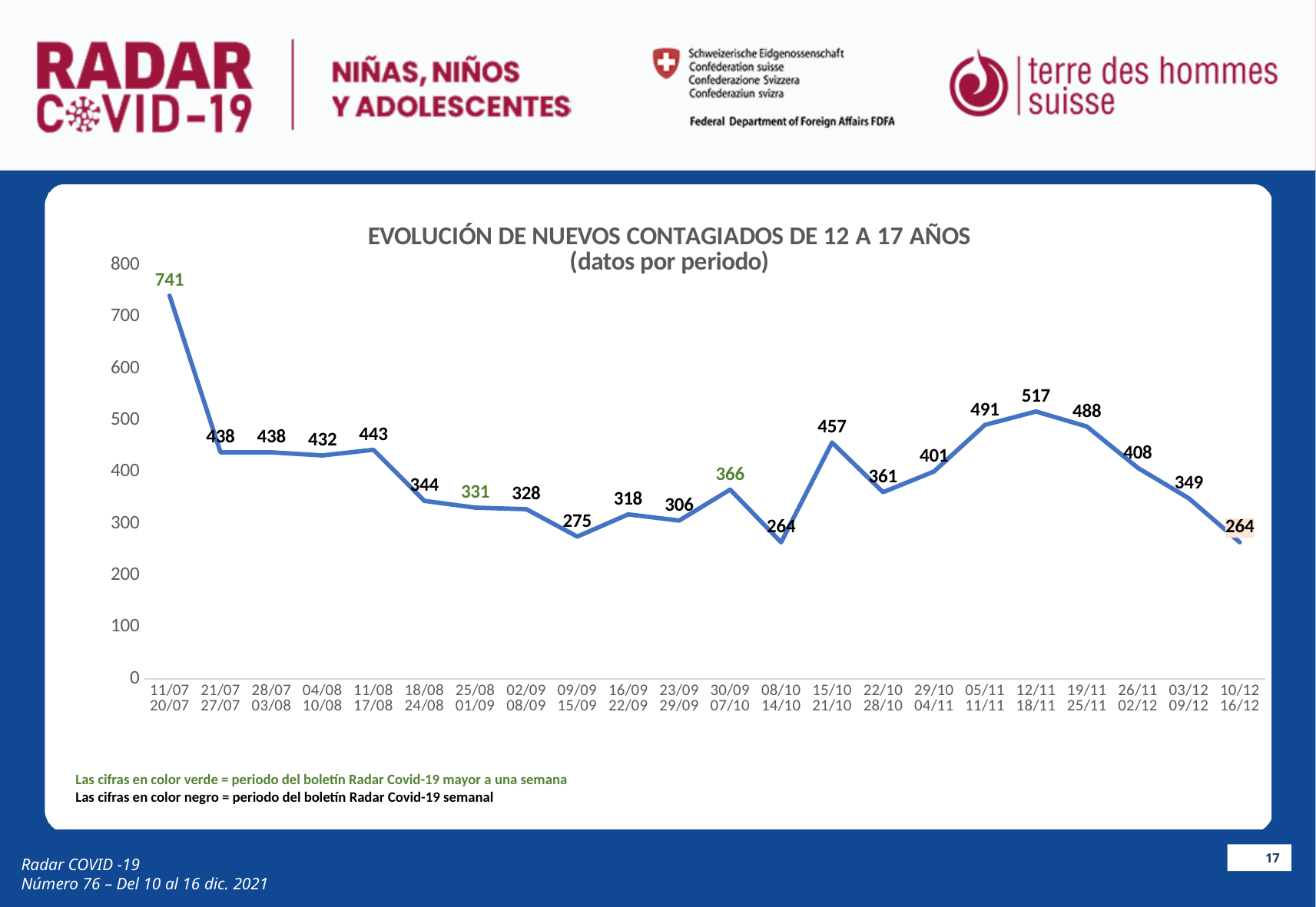
What is the value for the period 11/07–20/07? 741 What is the value for the period 12/11–18/11? 517 Which period has the highest value? 11/07–20/07 What is the difference between the values for 11/07–20/07 and 21/07–27/07? 303 How many periods (data points) are plotted on the chart? 22 What is the title of the chart? EVOLUCIÓN DE NUEVOS CONTAGIADOS DE 12 A 17 AÑOS (datos por periodo) What is the value for the period 08/10–14/10? 264 What is the lowest value plotted on the chart? 264 Which is larger, the value for 15/10–21/10 or the value for 22/10–28/10? 15/10–21/10 What type of chart is shown on the slide? line chart Do the values rise or fall from 12/11–18/11 to 10/12–16/12? fall What is the value for the period 25/08–01/09? 331